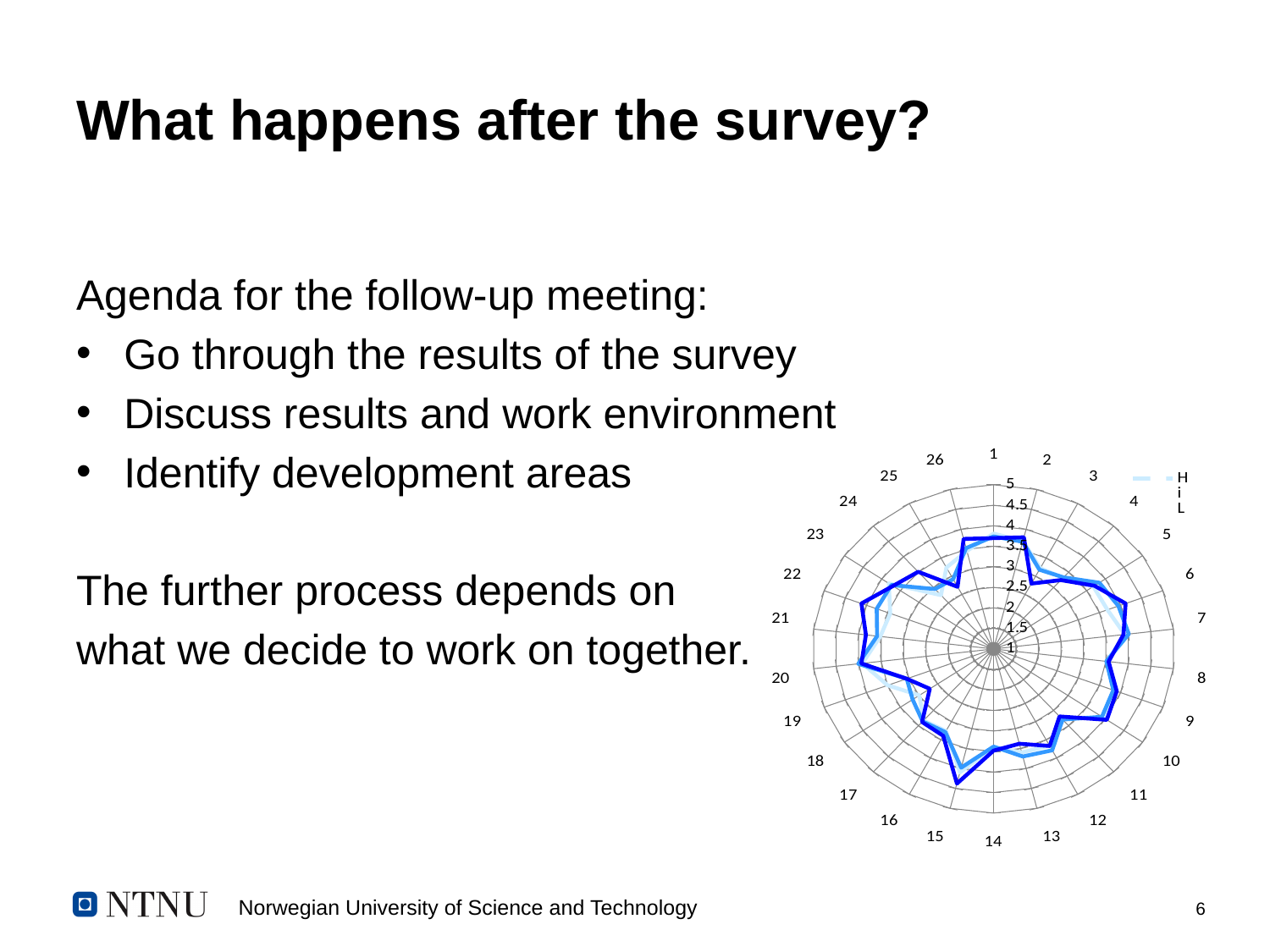
What is the highest value shown on the radar chart's axis? 5 What is the lowest value shown on the radar chart's axis? 1 Is the dark blue line's value for category 24 greater or less than 4? less Is the dark blue line's value for category 14 greater or less than 2? greater How many categories are plotted around the radar chart? 26 Is the dark blue line's value for category 7 greater or less than 3? greater What kind of chart is shown on the slide? radar chart